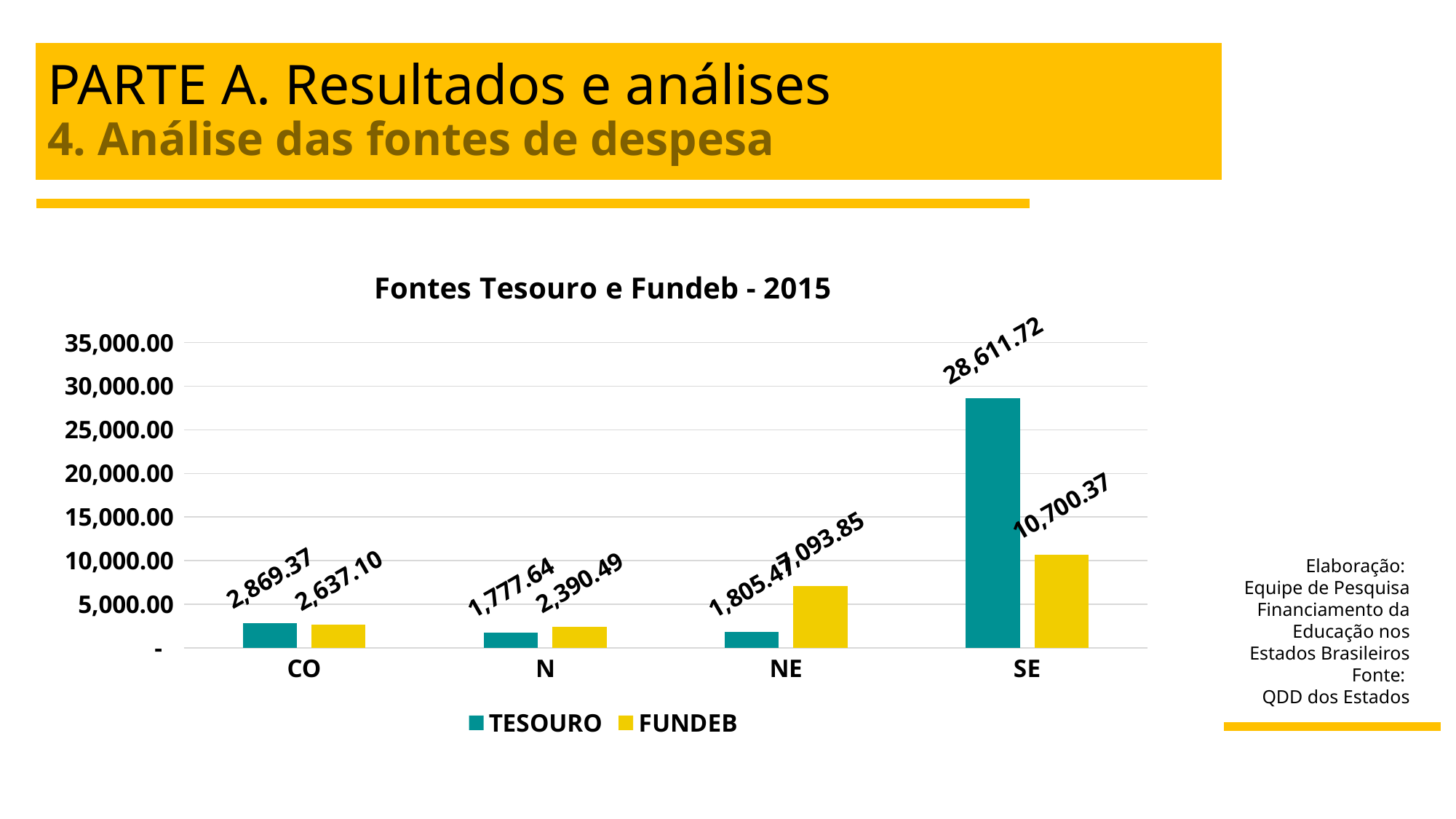
For CO, which is larger: TESOURO or FUNDEB? TESOURO What is the TESOURO value for SE? 28,611.72 Which region has the lowest FUNDEB value? N Is the FUNDEB value for SE greater or less than 10,000.00? greater What is the difference between the TESOURO and FUNDEB values for SE? 17,911.35 For NE, which is larger: TESOURO or FUNDEB? FUNDEB What is the TESOURO value for N? 1,777.64 Which region has the highest TESOURO value? SE What is the difference between the FUNDEB and TESOURO values for N? 612.85 How many regions are shown on the x axis? 4 What is the FUNDEB value for CO? 2,637.10 What is the FUNDEB value for NE? 7,093.85